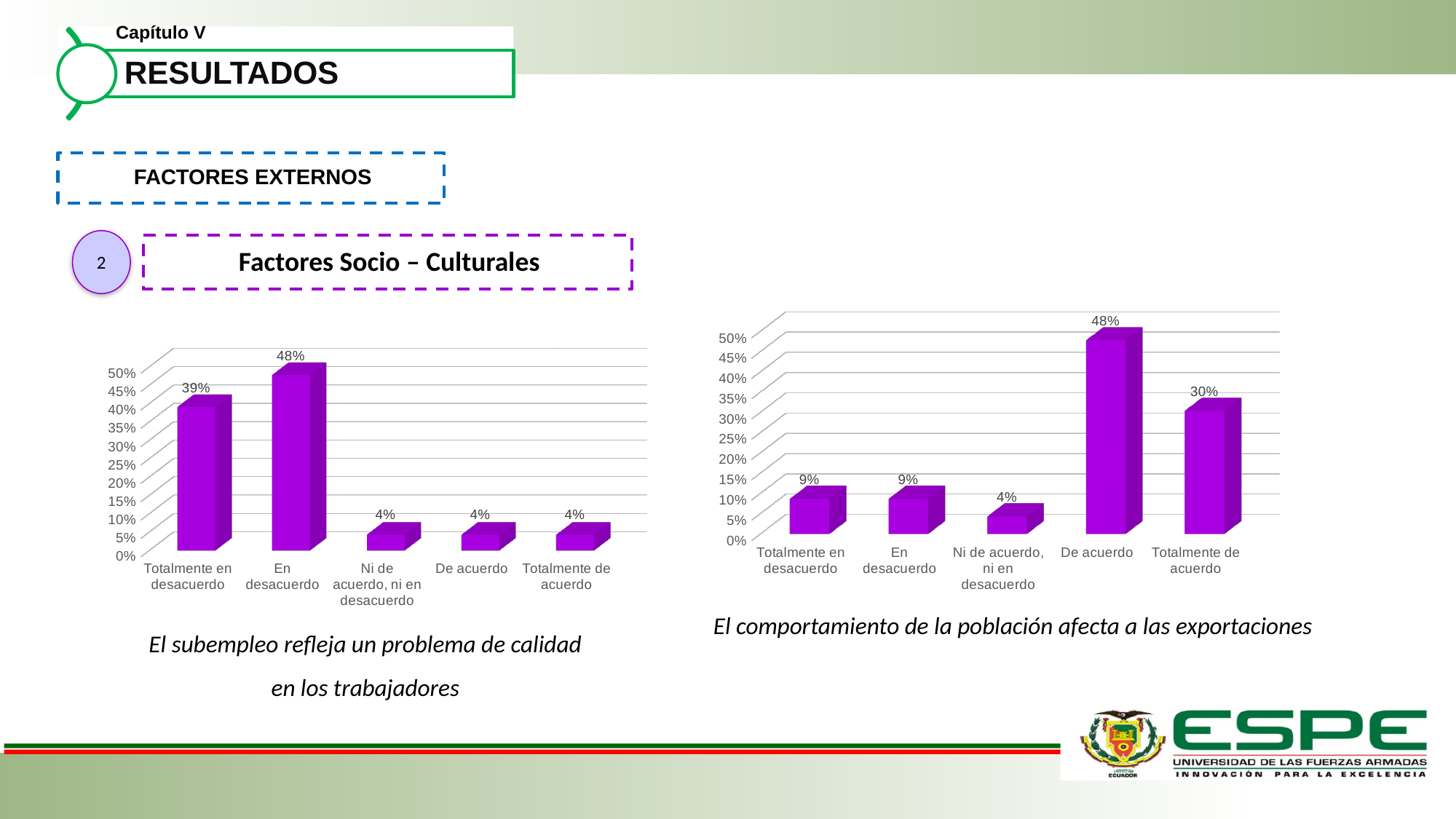
In the left chart (El subempleo refleja un problema de calidad en los trabajadores), what is the difference between 'En desacuerdo' and 'Totalmente en desacuerdo'? 9% In the left chart (El subempleo refleja un problema de calidad en los trabajadores), how many categories are shown? 5 In the right chart (El comportamiento de la población afecta a las exportaciones), which category has the lowest value? Ni de acuerdo, ni en desacuerdo What colour are the bars in the left chart (El subempleo refleja un problema de calidad en los trabajadores)? Purple In the left chart (El subempleo refleja un problema de calidad en los trabajadores), what is the value for 'Totalmente en desacuerdo'? 39% In the left chart (El subempleo refleja un problema de calidad en los trabajadores), which category has the highest value? En desacuerdo In the right chart (El comportamiento de la población afecta a las exportaciones), what is the value for 'De acuerdo'? 48% In the right chart (El comportamiento de la población afecta a las exportaciones), what is the difference between 'De acuerdo' and 'Totalmente de acuerdo'? 18% In the right chart (El comportamiento de la población afecta a las exportaciones), what is the value for 'Totalmente de acuerdo'? 30% In the left chart (El subempleo refleja un problema de calidad en los trabajadores), what is the value for 'En desacuerdo'? 48% What kind of chart is the right chart (El comportamiento de la población afecta a las exportaciones)? Bar chart In the right chart (El comportamiento de la población afecta a las exportaciones), which is larger: 'Totalmente en desacuerdo' or 'Ni de acuerdo, ni en desacuerdo'? Totalmente en desacuerdo